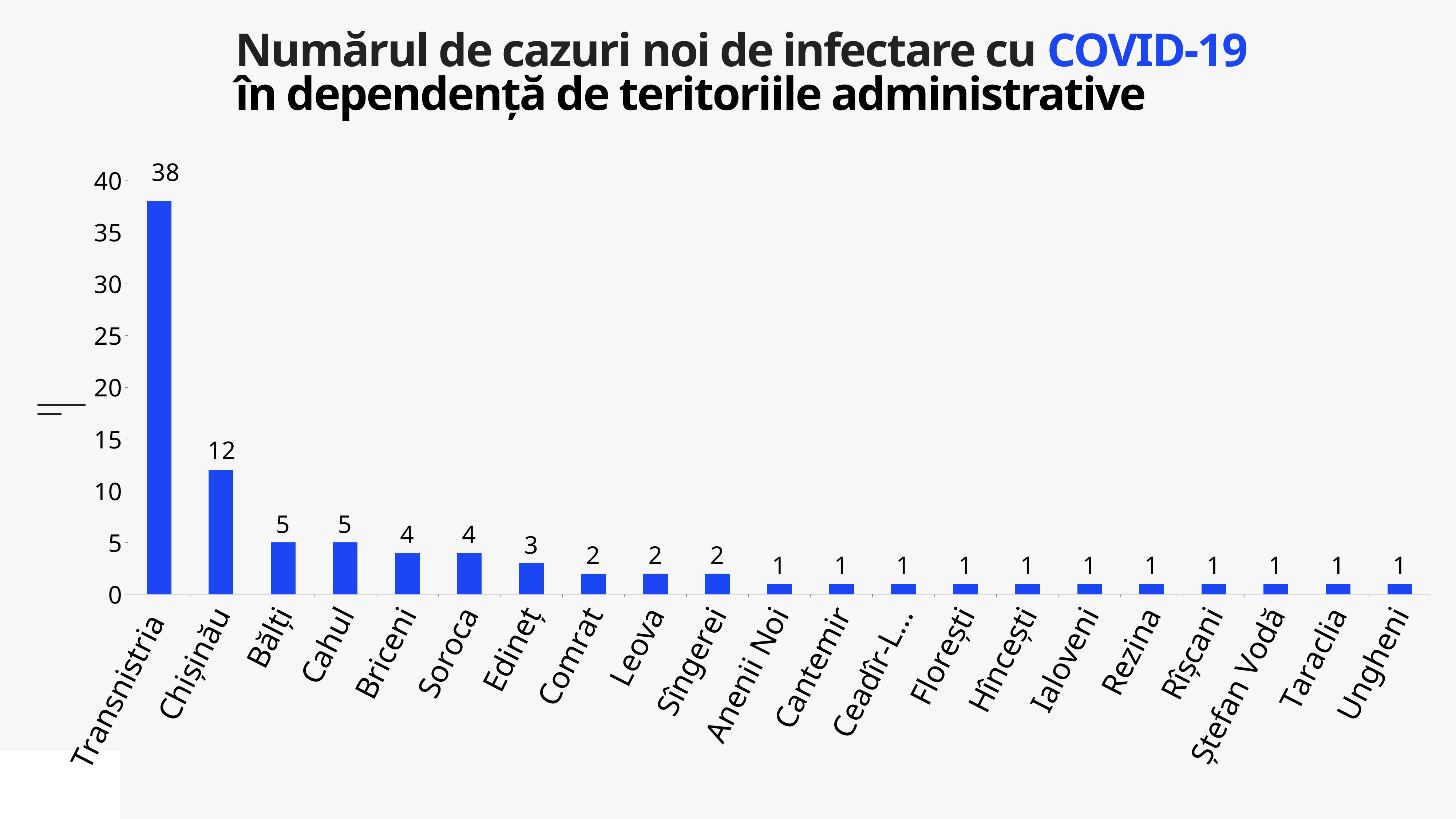
What is the value for Transnistria? 38 What is the difference between the values for Bălți and Comrat? 3 What is the difference between the values for Transnistria and Chișinău? 26 Is the value for Chișinău greater or less than 10? greater What kind of chart is shown on the slide? bar chart Do the values rise or fall from left to right along the x axis? fall Which is larger, the value for Briceni or the value for Leova? Briceni What is the value for Edineț? 3 Which territory has the highest number of new cases? Transnistria What is the value for Chișinău? 12 What is the value for Soroca? 4 How many territories are shown on the x axis? 21